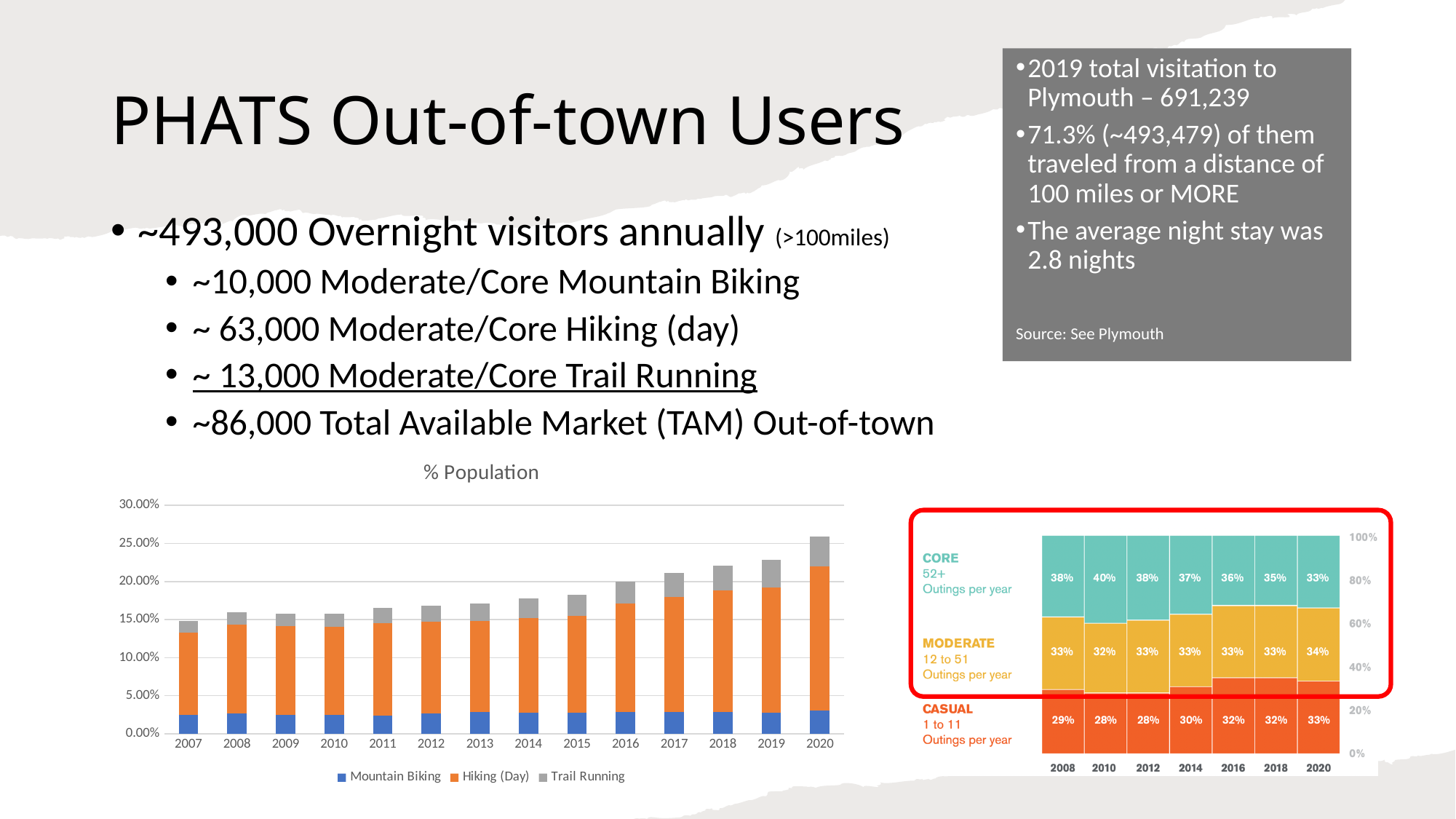
What kind of chart is the '% Population' chart? Stacked bar chart In the right-hand chart with CORE, MODERATE and CASUAL segments, which year has the highest CORE share? 2010 In the right-hand chart with CORE, MODERATE and CASUAL segments, what is the CASUAL share in 2020? 33% In the '% Population' chart, do the total bar heights generally rise or fall from 2007 to 2020? Rise In the '% Population' chart, which year has the tallest total bar? 2020 In the right-hand chart with CORE, MODERATE and CASUAL segments, what is the CORE share in 2010? 40% In the right-hand chart with CORE, MODERATE and CASUAL segments, how many years are shown on the x axis? 7 In the '% Population' chart, is the total bar for 2020 greater or less than 25.00%? greater In the right-hand chart with CORE, MODERATE and CASUAL segments, what is the difference between the CORE share in 2008 and the CORE share in 2020? 5% In the '% Population' chart, how many years are shown on the x axis? 14 In the '% Population' chart, how many series does the legend list? 3